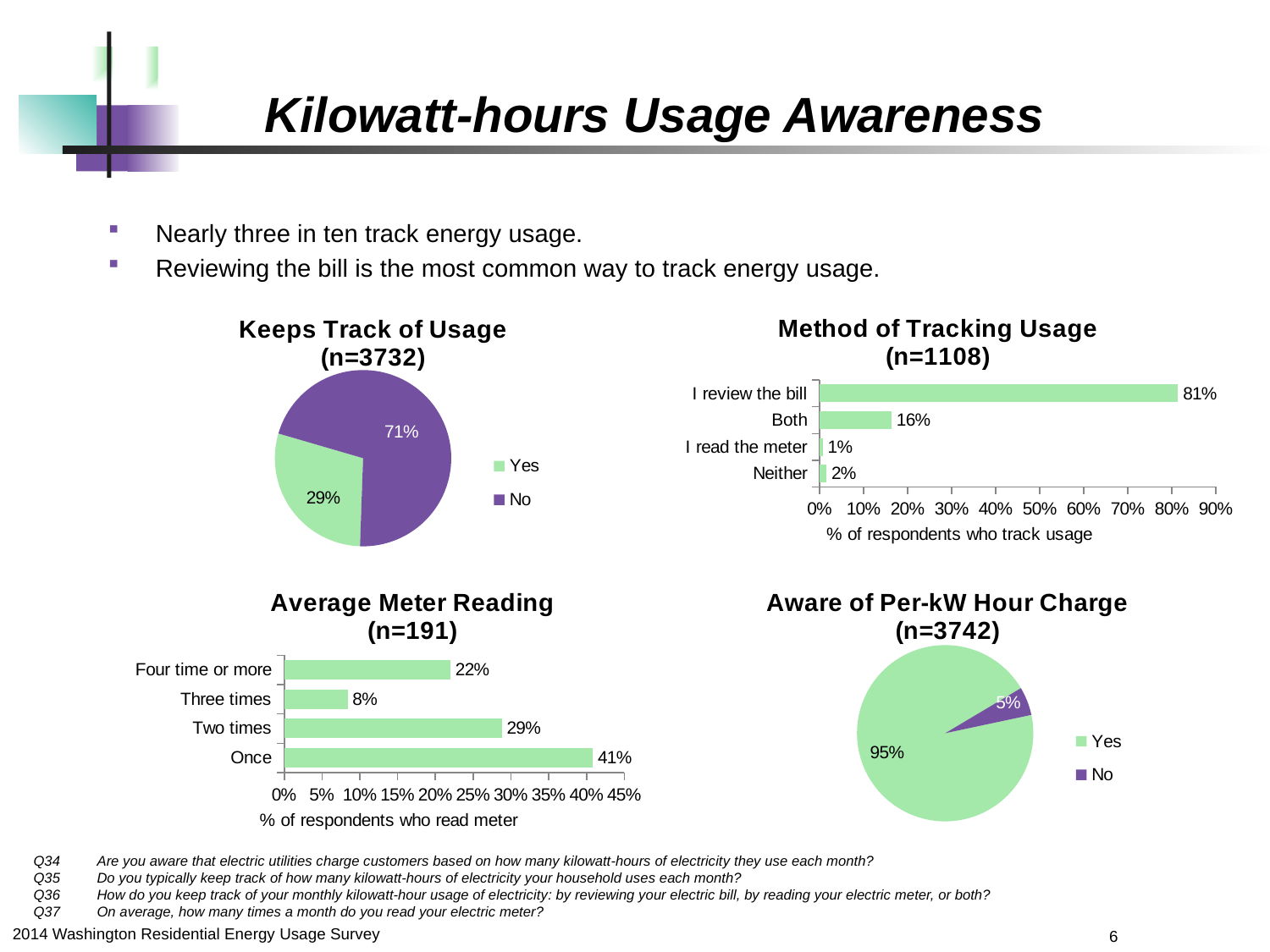
In the "Average Meter Reading" chart, what is the value for "Three times"? 8% How many categories are shown in the "Method of Tracking Usage" chart? 4 In the "Average Meter Reading" chart, which category has the highest value? Once In the "Average Meter Reading" chart, which is larger: "Four time or more" or "Two times"? Two times In the "Keeps Track of Usage" pie chart, what share of respondents answered No? 71% In the "Keeps Track of Usage" pie chart, what share of respondents answered Yes? 29% In the "Method of Tracking Usage" chart, which category has the lowest value? I read the meter In the "Method of Tracking Usage" chart, what is the difference between "I review the bill" and "Both"? 65% What kind of chart is the "Average Meter Reading" chart? Bar chart In the "Method of Tracking Usage" chart, what is the value for "I review the bill"? 81% How many entries does the legend of the "Aware of Per-kW Hour Charge" pie chart list? 2 In the "Aware of Per-kW Hour Charge" pie chart, what share of respondents answered No? 5%